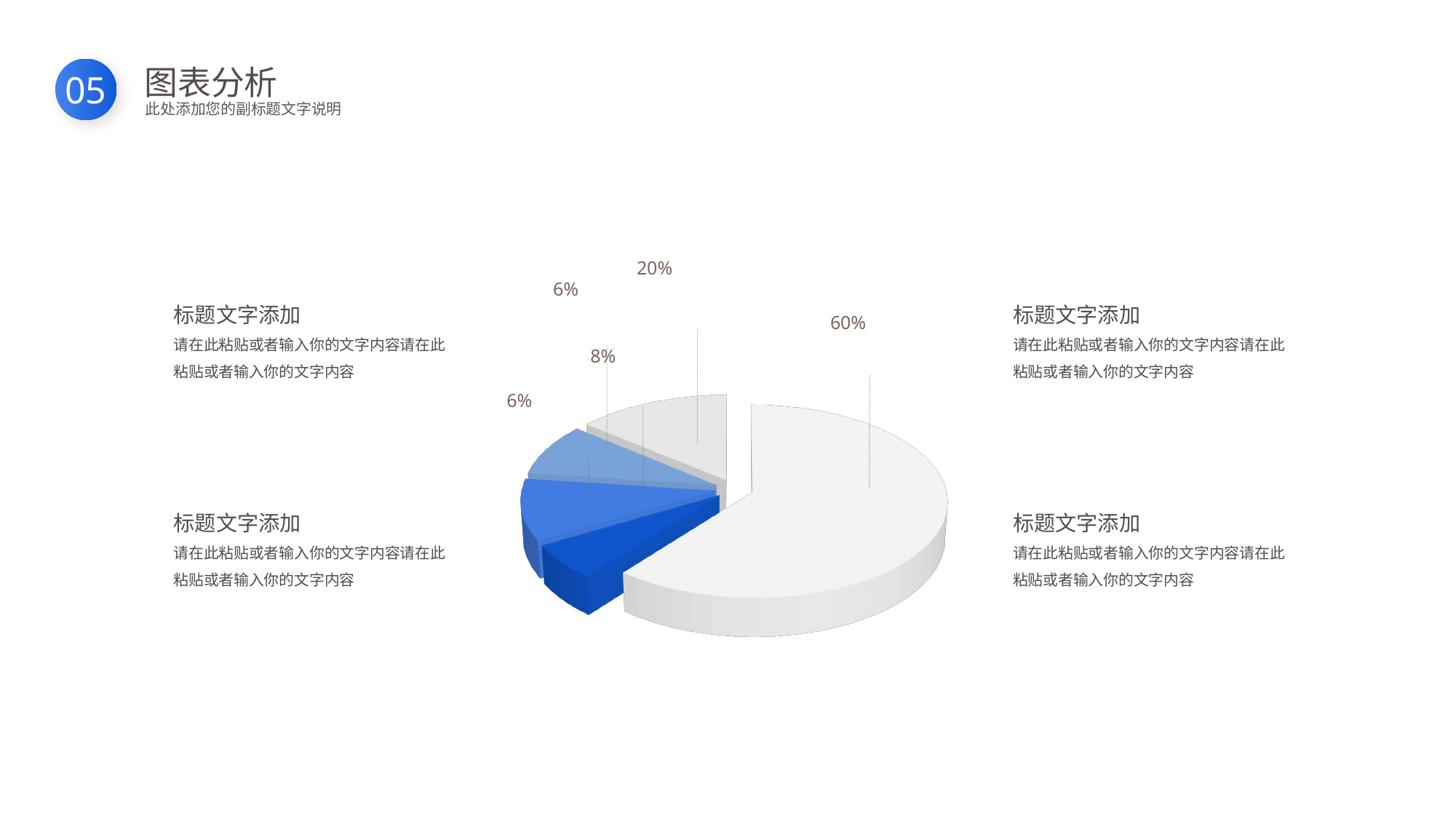
How many slices of the pie chart are coloured blue? 3 What share of the pie does the largest slice represent? 60% What is the largest value labelled on the pie chart? 60% Is the largest slice of the pie chart greater or less than 50%? greater Which is larger, the 20% slice or the 8% slice? The 20% slice What do the labelled slice values of the pie chart add up to? 100% How many slices does the pie chart have? 5 What is the smallest value labelled on the pie chart? 6% What is the title of the slide containing the pie chart? 图表分析 What is the difference between the largest slice (60%) and the second largest slice (20%)? 40 percentage points How many slices of the pie chart are labelled 6%? 2 What kind of chart is shown on the slide? Pie chart